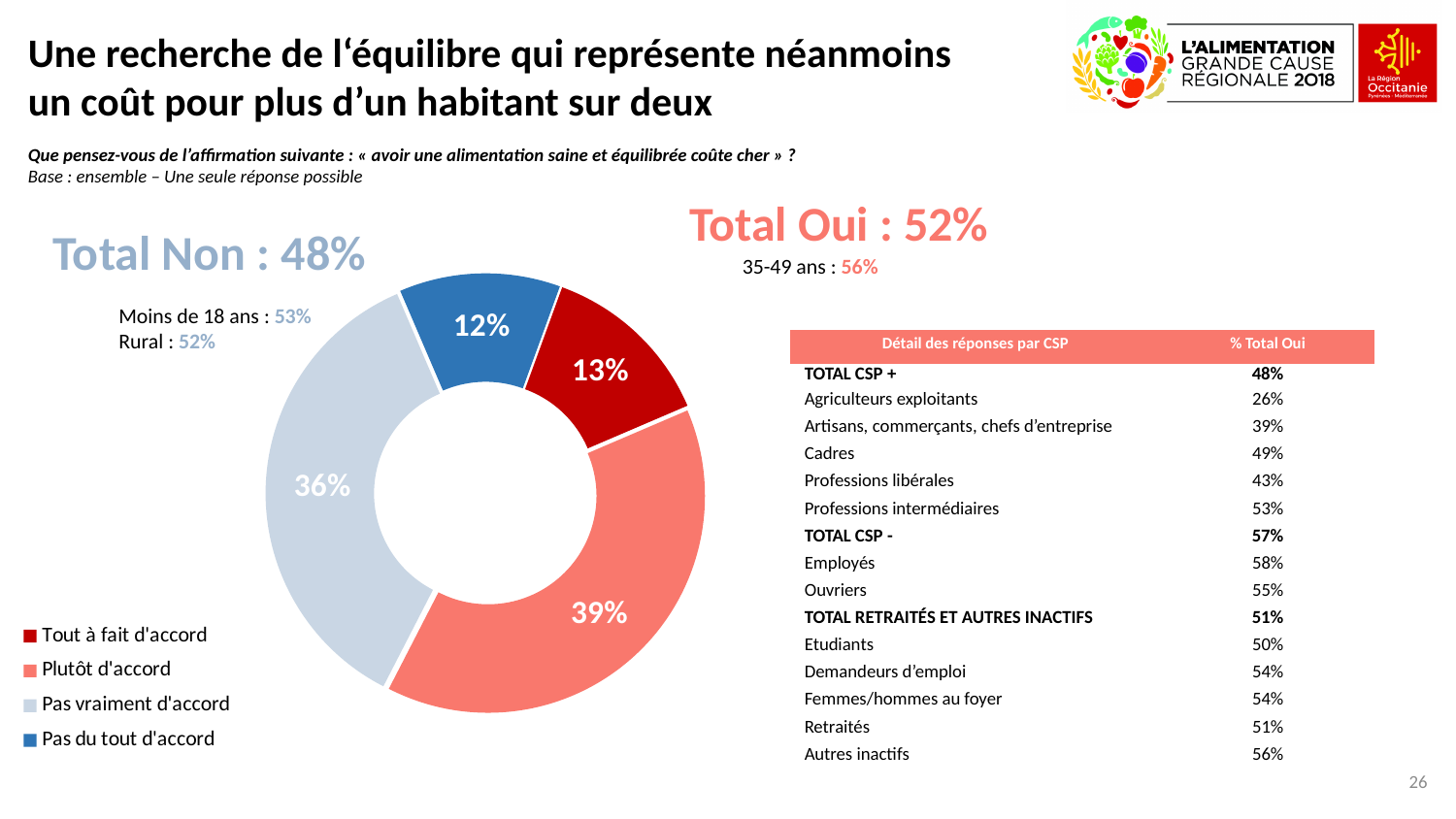
What percentage of respondents answered "Plutôt d'accord"? 39% Which response has the largest share of the donut chart? Plutôt d'accord How many slices does the donut chart have? 4 What colour is the "Pas du tout d'accord" slice in the donut chart? Blue What kind of chart is shown on the slide? Donut (pie) chart What percentage of respondents answered "Pas vraiment d'accord"? 36% What percentage of respondents answered "Tout à fait d'accord"? 13% How many entries does the chart legend list? 4 Which is larger: the share for "Tout à fait d'accord" or for "Pas du tout d'accord"? Tout à fait d'accord What percentage of respondents answered "Pas du tout d'accord"? 12% What is the difference between the "Plutôt d'accord" and "Pas vraiment d'accord" shares? 3 percentage points Which response has the smallest share of the donut chart? Pas du tout d'accord